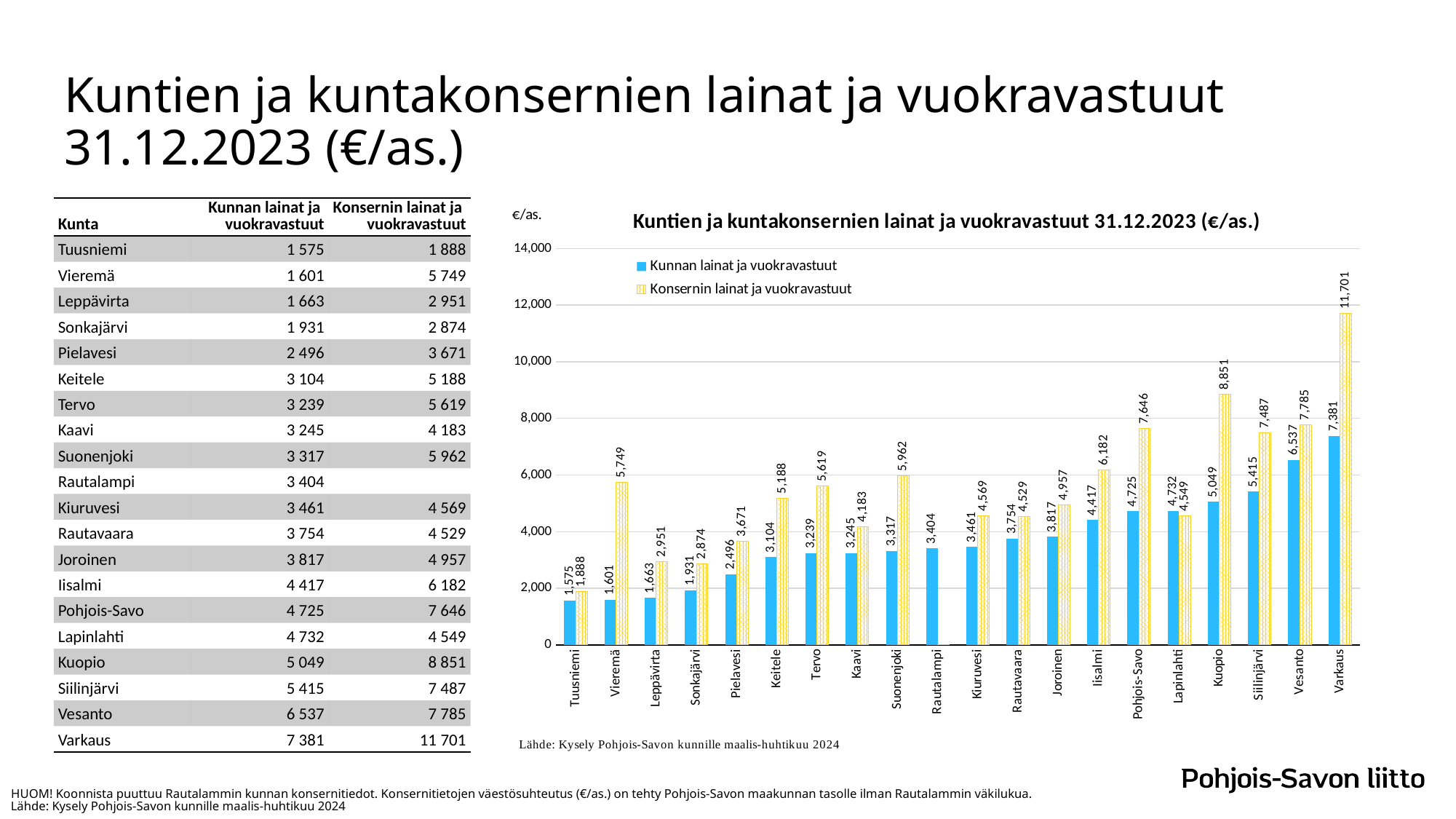
Do the Kunnan lainat ja vuokravastuut values rise or fall from left to right along the x axis? rise How many municipalities/categories are shown on the x axis of the chart? 20 What is the value of Konsernin lainat ja vuokravastuut for Vieremä? 5,749 Which municipality has the highest Konsernin lainat ja vuokravastuut value? Varkaus What is the difference between the Konsernin and Kunnan lainat ja vuokravastuut values for Vieremä? 4,148 What is the value of Kunnan lainat ja vuokravastuut for Kuopio? 5,049 What kind of chart is shown on the slide? bar chart How many series does the chart legend list? 2 Is the Konsernin lainat ja vuokravastuut value for Kuopio greater or less than 8,000? greater For Lapinlahti, which is larger: Kunnan lainat ja vuokravastuut or Konsernin lainat ja vuokravastuut? Kunnan lainat ja vuokravastuut What is the difference between the Konsernin and Kunnan lainat ja vuokravastuut values for Kuopio? 3,802 Which municipality has the lowest Kunnan lainat ja vuokravastuut value? Tuusniemi